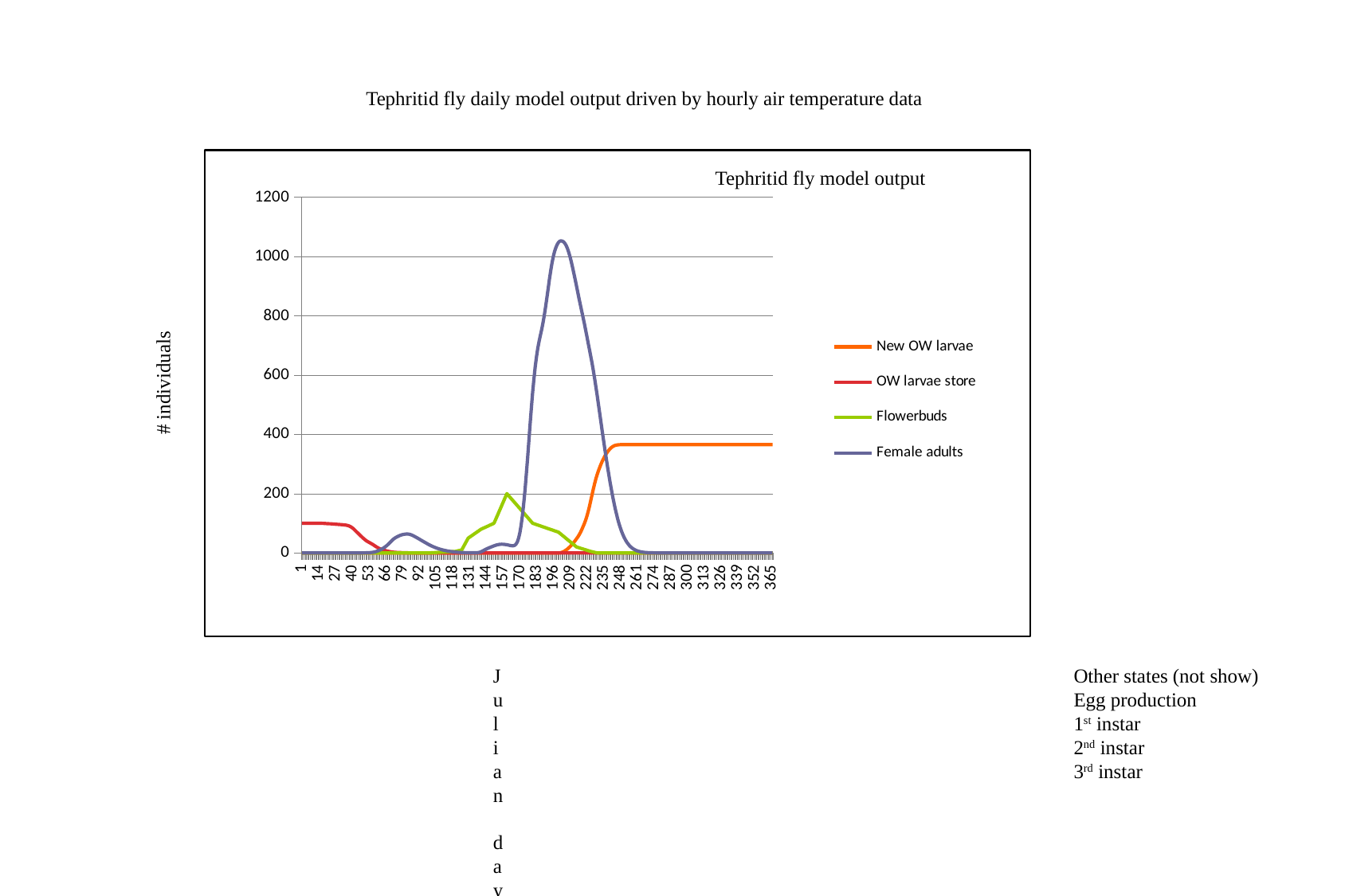
How many series does the legend list? 4 Does the OW larvae store series rise or fall over the first 66 days? fall What is the label on the vertical axis? # individuals Does the New OW larvae series rise or fall between day 209 and day 261? rise Is the final value for New OW larvae at day 365 greater or less than 200? greater What is the title of the chart? Tephritid fly model output Is the value for OW larvae store at day 1 greater or less than 200? less What kind of chart is shown on the slide? line chart Which series reaches the highest value on the chart? Female adults Is the peak value for Female adults greater or less than 1000? greater Which series has a higher peak value, Female adults or Flowerbuds? Female adults